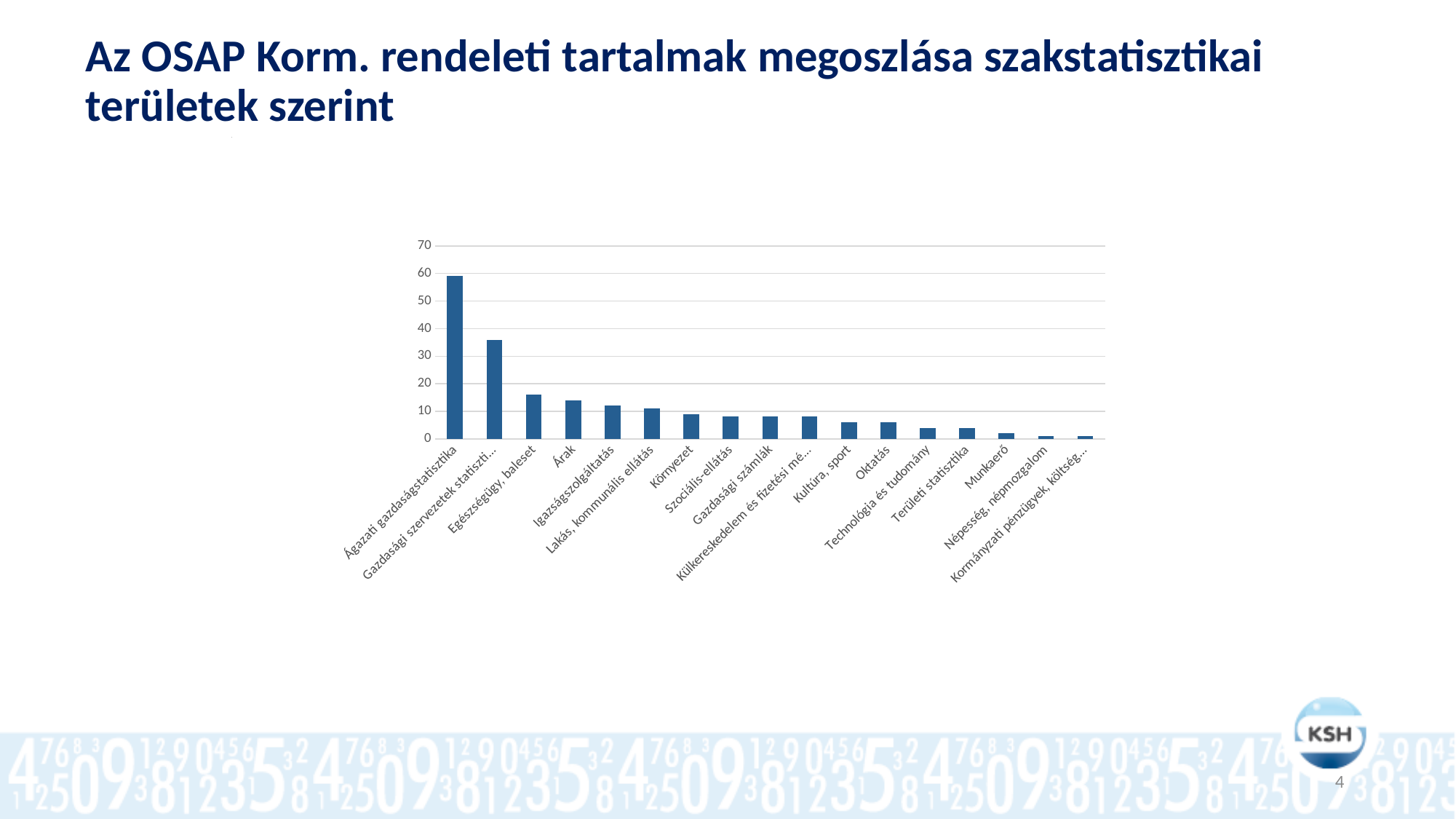
Which is larger, the value for Környezet or the value for Munkaerő? Környezet Is the value for Oktatás greater or less than 10? less What kind of chart is shown on the slide? bar chart Is the value for Árak greater or less than 10? greater Is the value for Ágazati gazdaságstatisztika greater or less than 50? greater Do the bar values rise or fall from left to right along the x axis? fall How many categories are plotted on the chart? 17 What is the title of the slide containing the chart? Az OSAP Korm. rendeleti tartalmak megoszlása szakstatisztikai területek szerint Which category has the highest value? Ágazati gazdaságstatisztika Which is larger, the value for Igazságszolgáltatás or the value for Technológia és tudomány? Igazságszolgáltatás